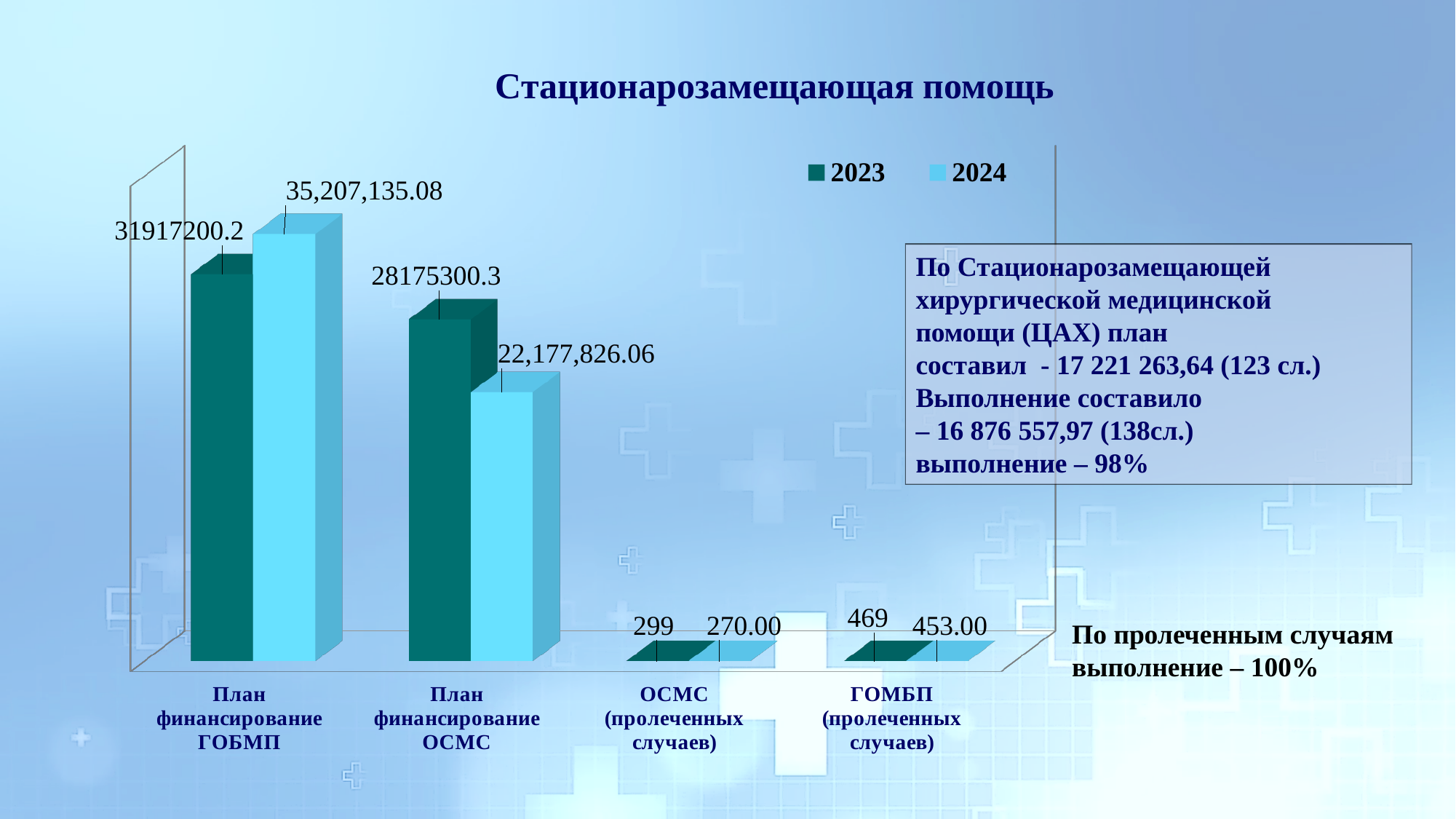
For План финансирование ОСМС, which year has the larger value, 2023 or 2024? 2023 What is the 2024 value for План финансирование ОСМС? 22,177,826.06 Which category has the highest 2024 value? План финансирование ГОБМП What is the 2023 value for ОСМС (пролеченных случаев)? 299 What kind of chart is shown on the slide? Bar chart What is the 2023 value for План финансирование ГОБМП? 31917200.2 What is the 2024 value for ГОМБП (пролеченных случаев)? 453.00 What is the 2024 value for План финансирование ГОБМП? 35,207,135.08 What is the difference between the 2023 and 2024 values for ОСМС (пролеченных случаев)? 29 What is the 2023 value for План финансирование ОСМС? 28175300.3 How many series does the legend list? 2 Which category has the lowest 2023 value? ОСМС (пролеченных случаев)